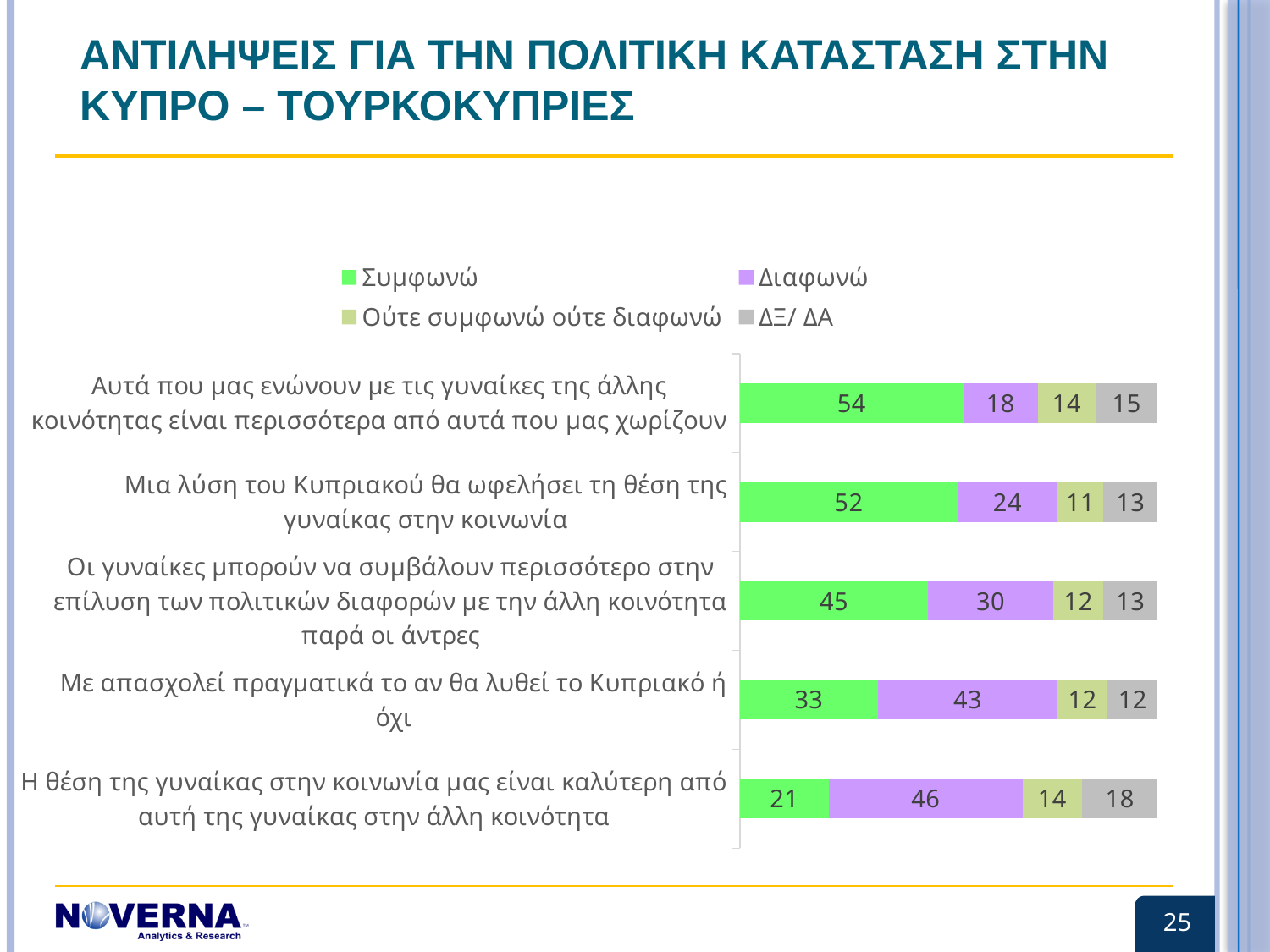
How many series does the legend list? 4 What is the Διαφωνώ value for the statement "Με απασχολεί πραγματικά το αν θα λυθεί το Κυπριακό ή όχι"? 43 What kind of chart is shown on the slide? Stacked bar chart What is the difference between the Συμφωνώ and Διαφωνώ values for the statement "Οι γυναίκες μπορούν να συμβάλουν περισσότερο στην επίλυση των πολιτικών διαφορών με την άλλη κοινότητα παρά οι άντρες"? 15 How many statements (categories) are plotted in the chart? 5 For the statement "Η θέση της γυναίκας στην κοινωνία μας είναι καλύτερη από αυτή της γυναίκας στην άλλη κοινότητα", which is larger: Συμφωνώ or Διαφωνώ? Διαφωνώ Which colour represents the Διαφωνώ series in the chart? Purple Which statement has the lowest Συμφωνώ value? Η θέση της γυναίκας στην κοινωνία μας είναι καλύτερη από αυτή της γυναίκας στην άλλη κοινότητα What is the ΔΞ/ΔΑ value for the statement "Η θέση της γυναίκας στην κοινωνία μας είναι καλύτερη από αυτή της γυναίκας στην άλλη κοινότητα"? 18 Which statement has the highest Συμφωνώ value? Αυτά που μας ενώνουν με τις γυναίκες της άλλης κοινότητας είναι περισσότερα από αυτά που μας χωρίζουν What is the total of the stacked bar for the statement "Αυτά που μας ενώνουν με τις γυναίκες της άλλης κοινότητας είναι περισσότερα από αυτά που μας χωρίζουν"? 101 What is the Συμφωνώ value for the statement "Μια λύση του Κυπριακού θα ωφελήσει τη θέση της γυναίκας στην κοινωνία"? 52